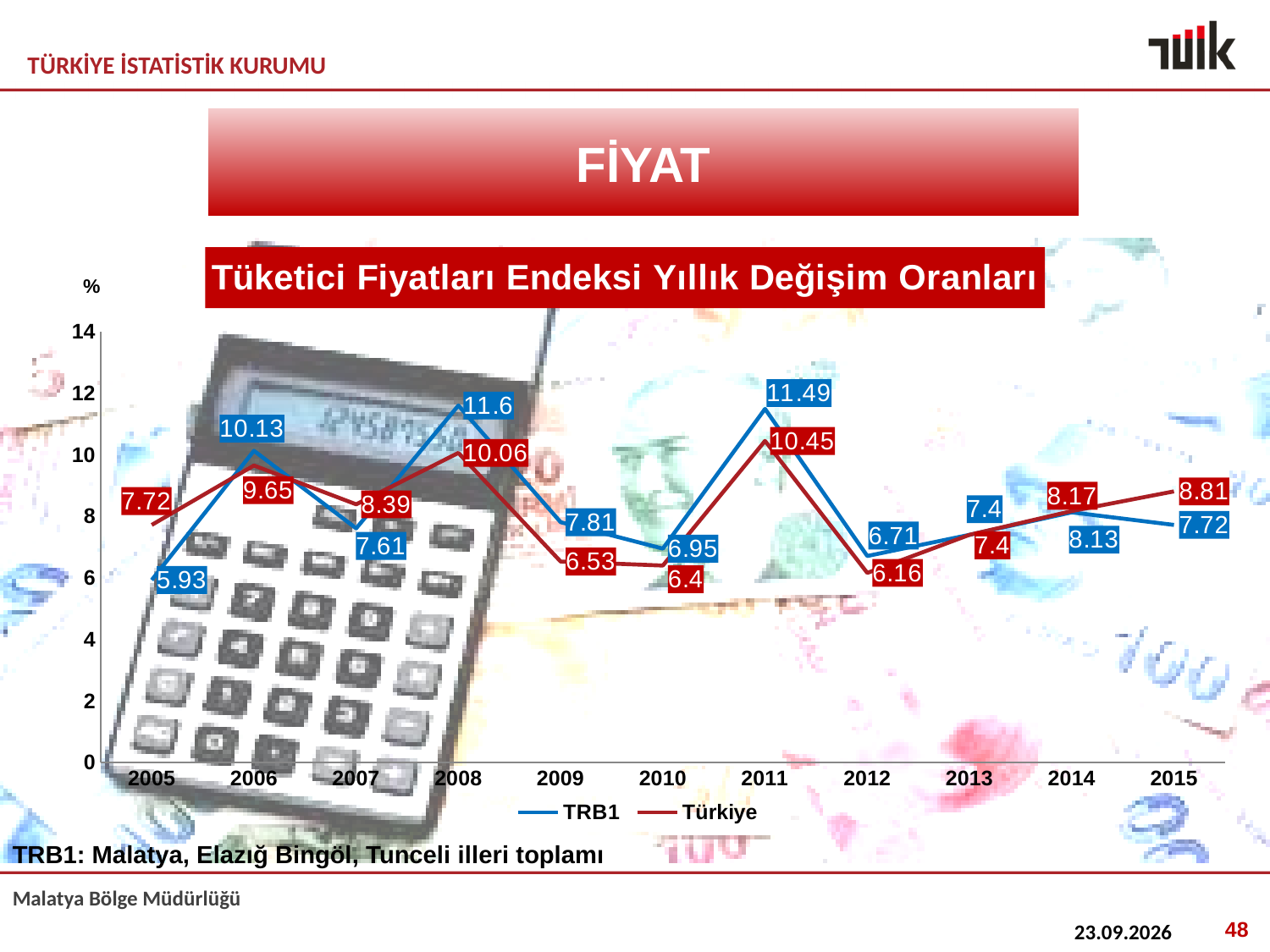
How many series does the legend list? 2 What is the difference between the TRB1 and Türkiye values in 2011? 1.04 Which series has the larger value in 2006, TRB1 or Türkiye? TRB1 What is the TRB1 value for 2005? 5.93 In which year is the TRB1 series highest? 2008 What is the TRB1 value for 2008? 11.6 What kind of chart is shown on the slide? line chart What is the Türkiye value for 2012? 6.16 Is the TRB1 value for 2011 greater or less than 10? greater How many years are shown on the x axis? 11 In which year is the Türkiye series lowest? 2012 What is the Türkiye value for 2015? 8.81